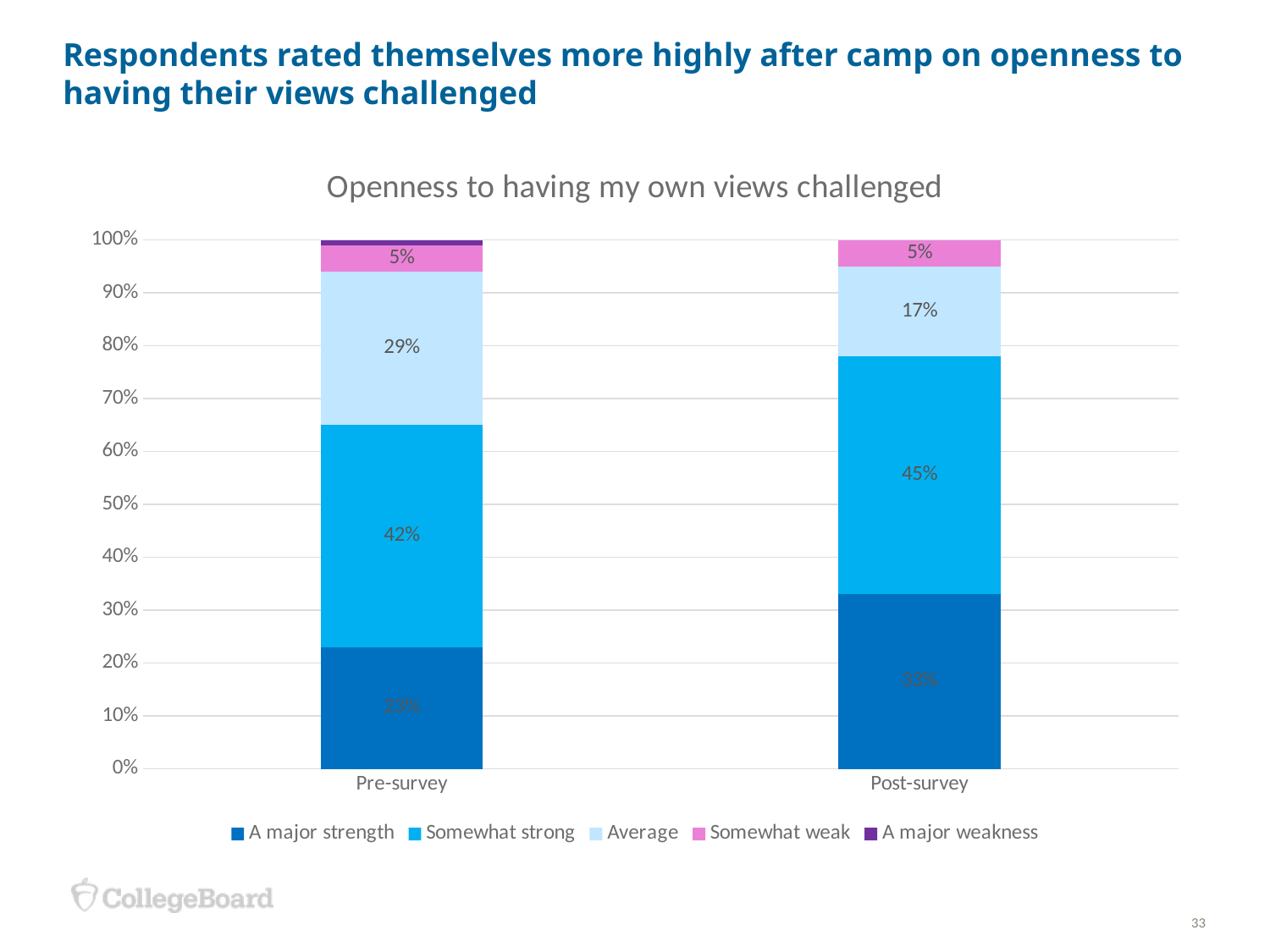
How many bars (survey categories) are shown on the x axis? 2 What is the "Somewhat weak" share in the Pre-survey bar? 5% Which rating category makes up the largest segment of the Post-survey bar? Somewhat strong How many series does the legend list? 5 What kind of chart is shown on the slide? Stacked bar chart What percentage of Post-survey respondents rated it "A major strength"? 33% By how many percentage points did the "A major strength" share rise from Pre-survey to Post-survey? 10 percentage points What is the title of the chart? Openness to having my own views challenged Which bar has the larger "A major strength" share, Pre-survey or Post-survey? Post-survey What percentage of Pre-survey respondents rated openness to having their views challenged as "Somewhat strong"? 42% By how many percentage points did the "Average" share fall from Pre-survey to Post-survey? 12 percentage points What is the "Average" share in the Post-survey bar? 17%